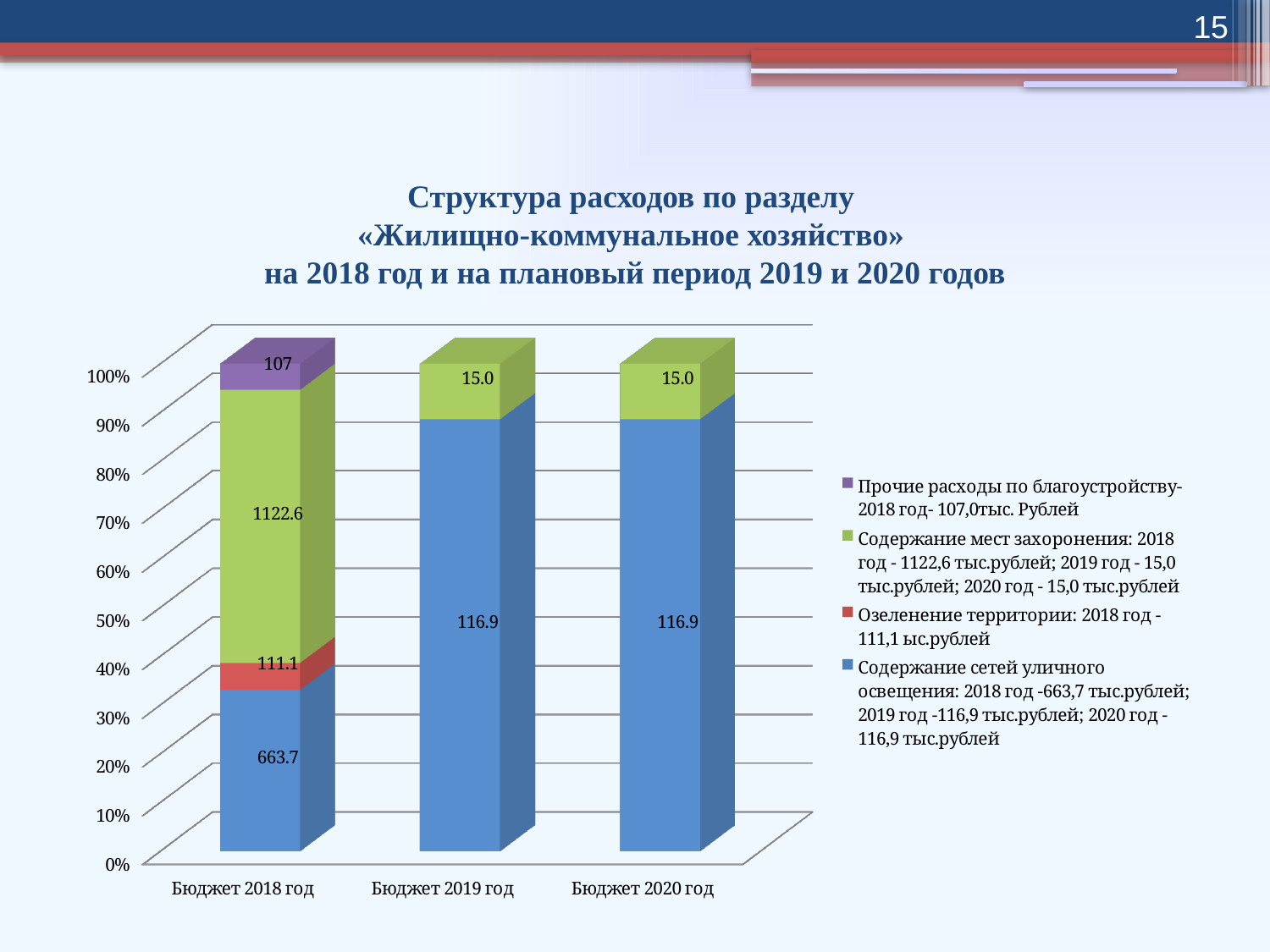
Which series has the largest value in the Бюджет 2018 год bar? Содержание мест захоронения What is the value for Прочие расходы по благоустройству in the Бюджет 2018 год bar? 107 Is the share of Содержание сетей уличного освещения in the Бюджет 2019 год bar greater or less than 80%? greater In the Бюджет 2020 год bar, which is larger: Содержание сетей уличного освещения or Содержание мест захоронения? Содержание сетей уличного освещения How many series does the legend list? 4 What is the total of the Бюджет 2019 год bar? 131.9 What is the value for Содержание сетей уличного освещения in the Бюджет 2018 год bar? 663.7 What is the value for Содержание мест захоронения in the Бюджет 2019 год bar? 15.0 What kind of chart is shown on the slide? Stacked bar chart What is the value for Озеленение территории in the Бюджет 2018 год bar? 111.1 How many budget years (categories) are shown on the x axis? 3 What is the difference between Содержание мест захоронения and Содержание сетей уличного освещения in the Бюджет 2018 год bar? 458.9